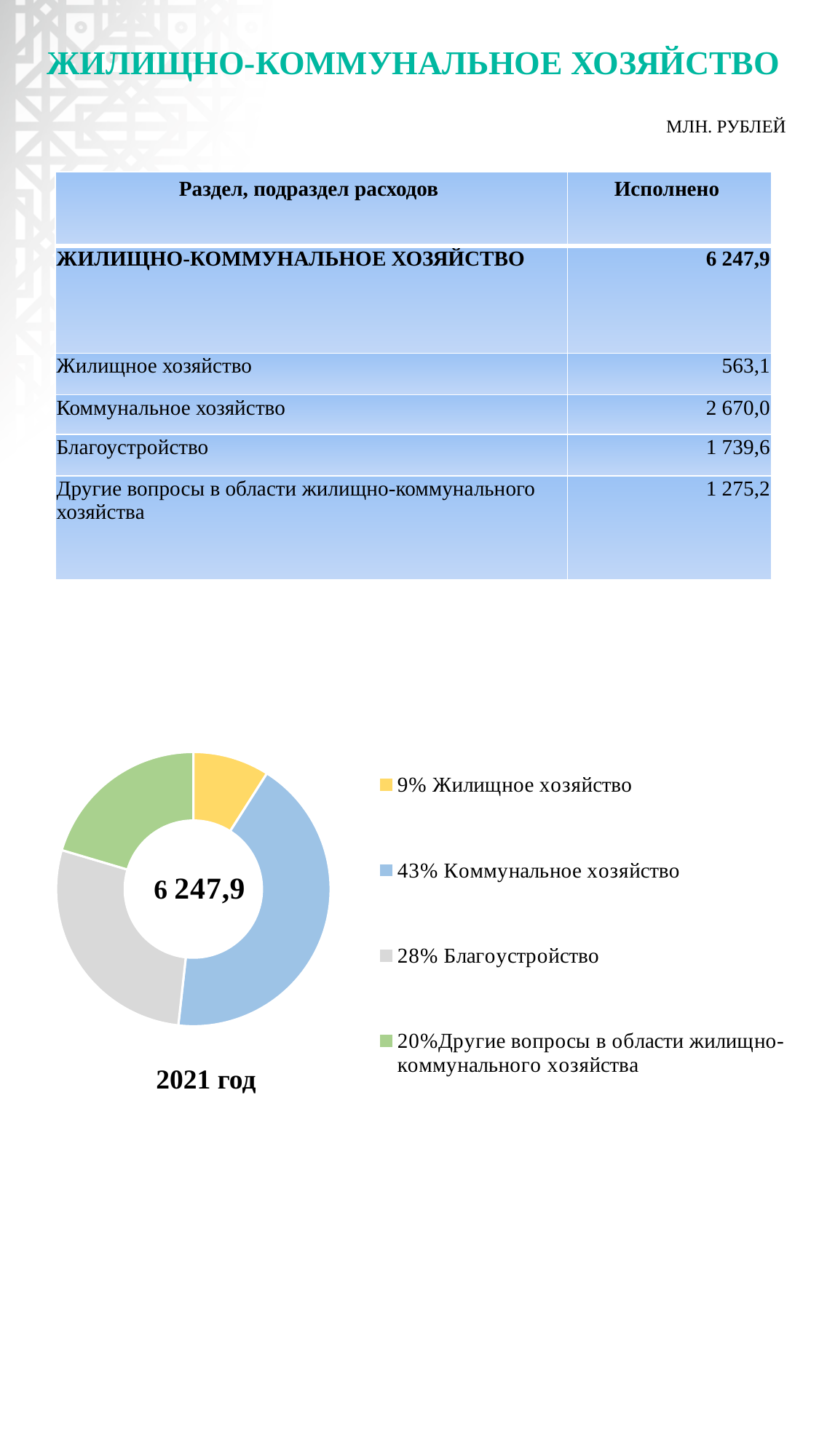
What kind of chart is shown on the slide? Doughnut chart What share of the pie chart does Жилищное хозяйство represent? 9% Which category has the smallest slice in the pie chart? Жилищное хозяйство Which year is labelled below the pie chart? 2021 год How many slices does the pie chart have? 4 What share of the pie chart does Другие вопросы в области жилищно-коммунального хозяйства represent? 20% By how many percentage points does the share of Коммунальное хозяйство exceed the share of Благоустройство in the pie chart? 15 What share of the pie chart does Коммунальное хозяйство represent? 43% Which slice is larger in the pie chart: Благоустройство or Другие вопросы в области жилищно-коммунального хозяйства? Благоустройство Which category has the largest slice in the pie chart? Коммунальное хозяйство What total value is printed in the centre of the pie chart? 6 247,9